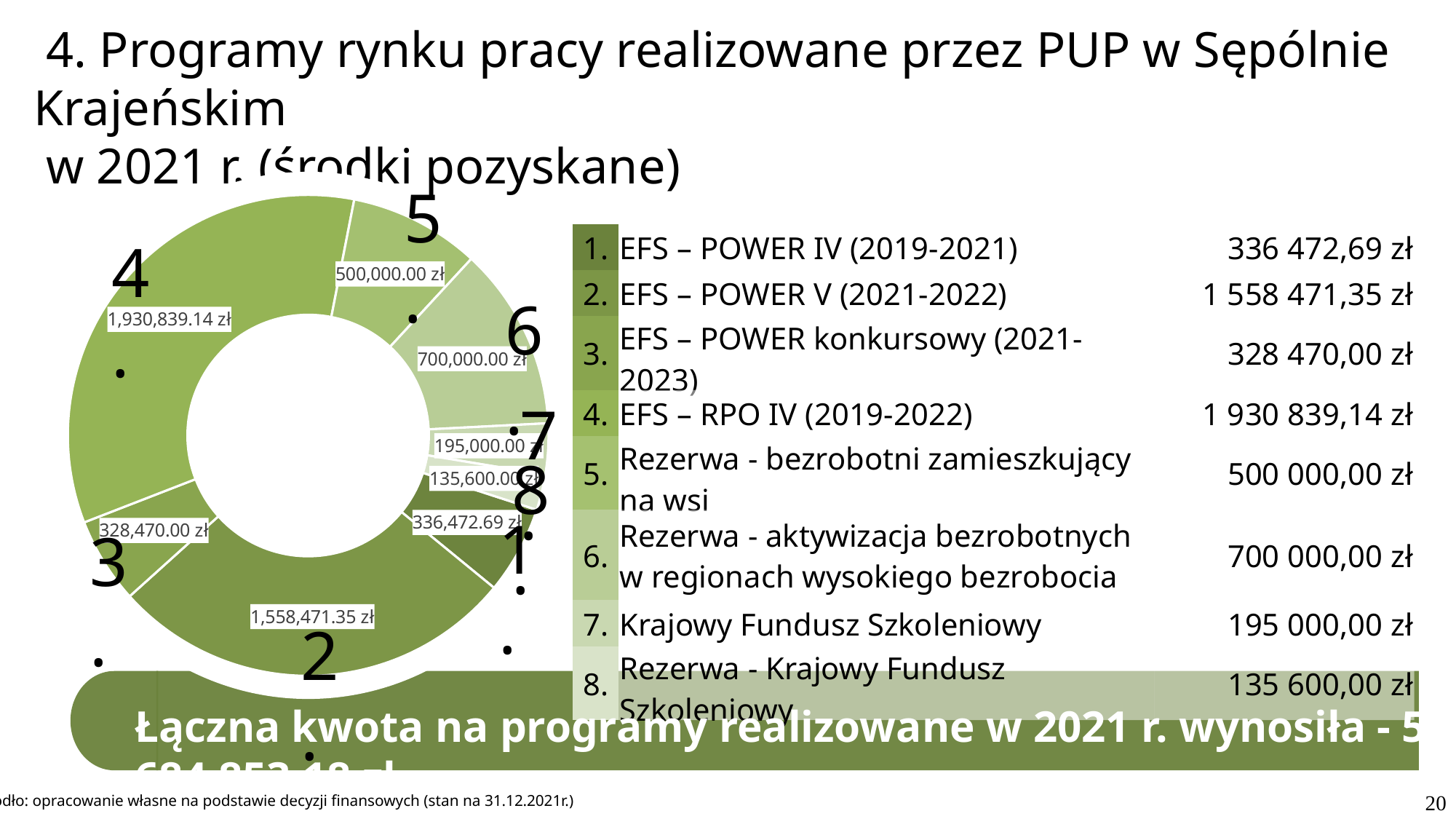
What is the difference between the values of slice 1 and slice 3 in the doughnut chart? 8,002.69 zł Which slice of the doughnut chart has the largest value? Slice 4 (EFS – RPO IV), 1,930,839.14 zł Which slice of the doughnut chart has the smallest value? Slice 8 (Rezerwa - Krajowy Fundusz Szkoleniowy), 135,600.00 zł What value is shown for slice 2 (EFS – POWER V) in the doughnut chart? 1,558,471.35 zł How many slices does the doughnut chart have? 8 Which is larger in the doughnut chart: slice 2 (EFS – POWER V) or slice 4 (EFS – RPO IV)? Slice 4 (EFS – RPO IV) What value is shown for slice 6 in the doughnut chart? 700,000.00 zł What value is shown for slice 4 (EFS – RPO IV) in the doughnut chart? 1,930,839.14 zł What kind of chart is shown on the slide? Doughnut (pie) chart What value is shown for slice 7 (Krajowy Fundusz Szkoleniowy) in the doughnut chart? 195,000.00 zł What is the difference between the values of slice 6 and slice 5 in the doughnut chart? 200,000.00 zł Which is larger in the doughnut chart: slice 7 or slice 8? Slice 7